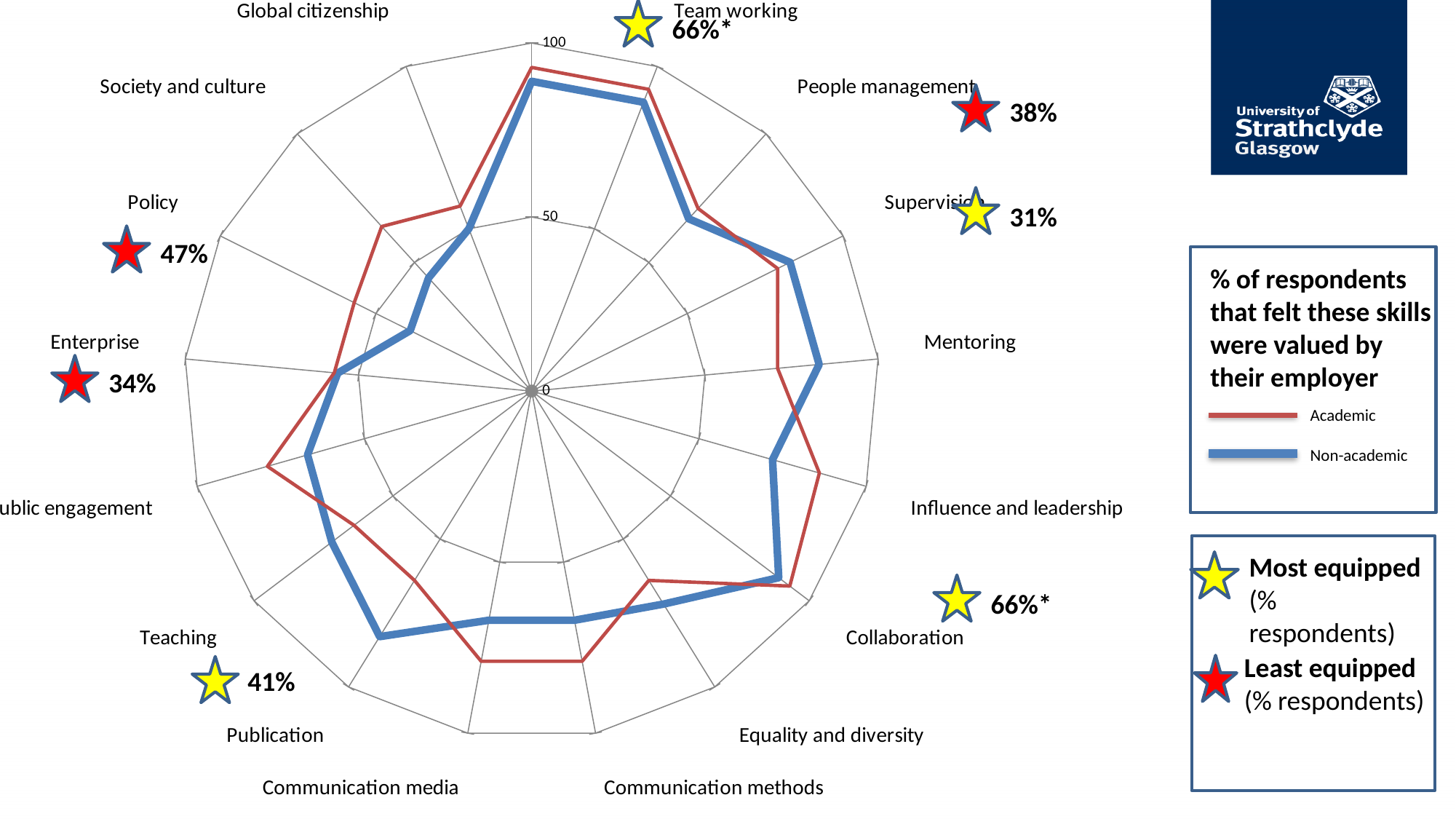
Is the Academic value for Communication methods greater or less than 50? greater What kind of chart is shown on the slide? Radar chart For Mentoring, which series has the larger value, Academic or Non-academic? Non-academic For Influence and leadership, which series has the larger value, Academic or Non-academic? Academic Is the Academic value for Team working greater or less than 50? greater How many series does the chart's legend list? 2 Is the Non-academic value for Mentoring greater or less than 50? greater For Public engagement, which series has the larger value, Academic or Non-academic? Academic What is the title of the chart? % of respondents that felt these skills were valued by their employer What percentage is shown next to the red star for Policy? 47%